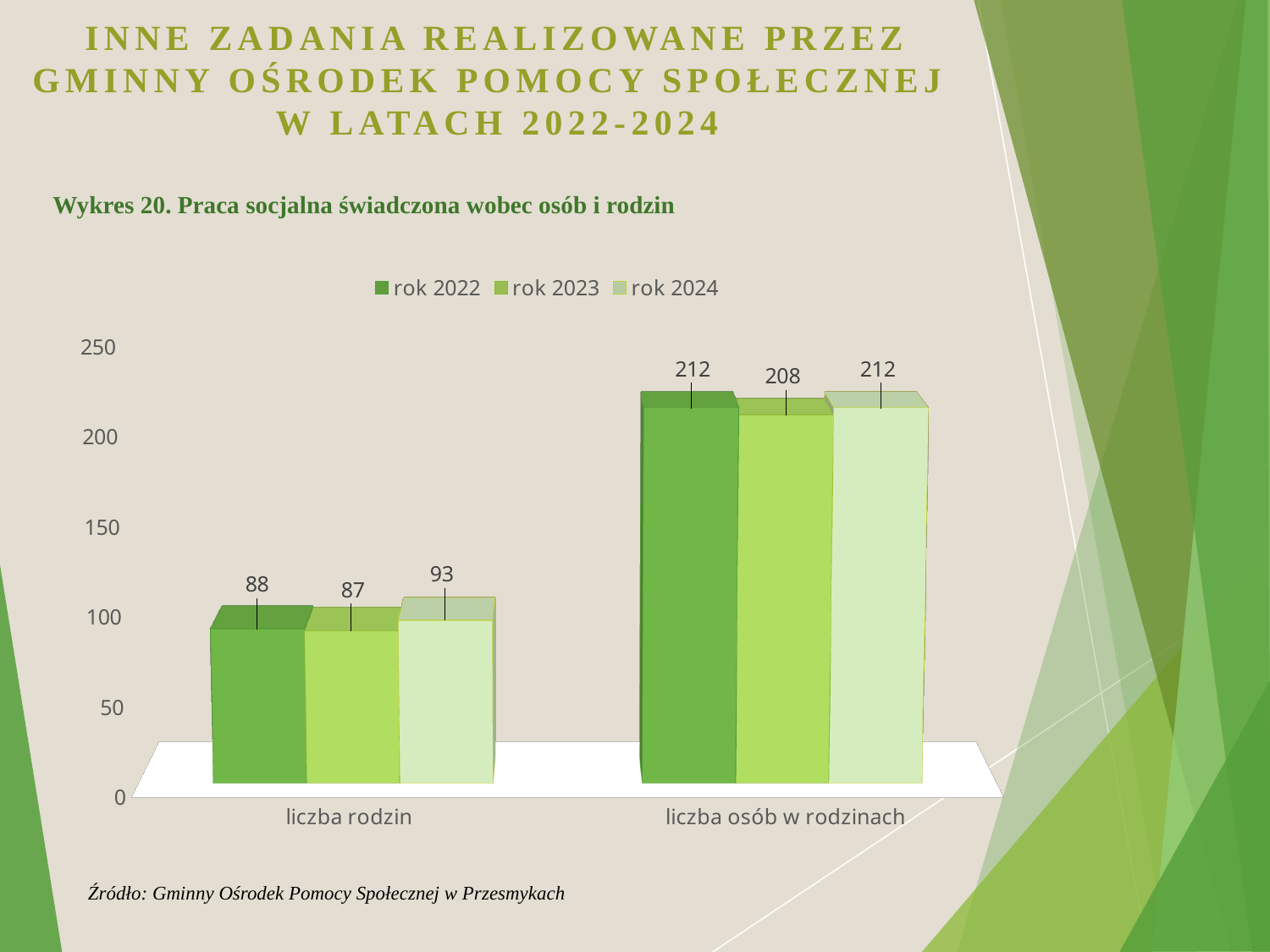
What is the difference between the 'rok 2022' and 'rok 2023' values for 'liczba osób w rodzinach'? 4 Which is larger: the 'rok 2022' value for 'liczba rodzin' or the 'rok 2023' value for 'liczba rodzin'? rok 2022 Which year has the lowest value for 'liczba osób w rodzinach'? rok 2023 What is the value for 'liczba rodzin' in the 'rok 2022' series? 88 How many series does the legend list? 3 What is the difference between the 'rok 2024' and 'rok 2023' values for 'liczba rodzin'? 6 What is the value for 'liczba rodzin' in the 'rok 2024' series? 93 Which year has the highest value for 'liczba rodzin'? rok 2024 How many categories are shown on the x axis? 2 What kind of chart is shown on the slide? bar chart Is the value for 'liczba osób w rodzinach' in 'rok 2022' greater or less than 200? greater What is the value for 'liczba osób w rodzinach' in the 'rok 2023' series? 208